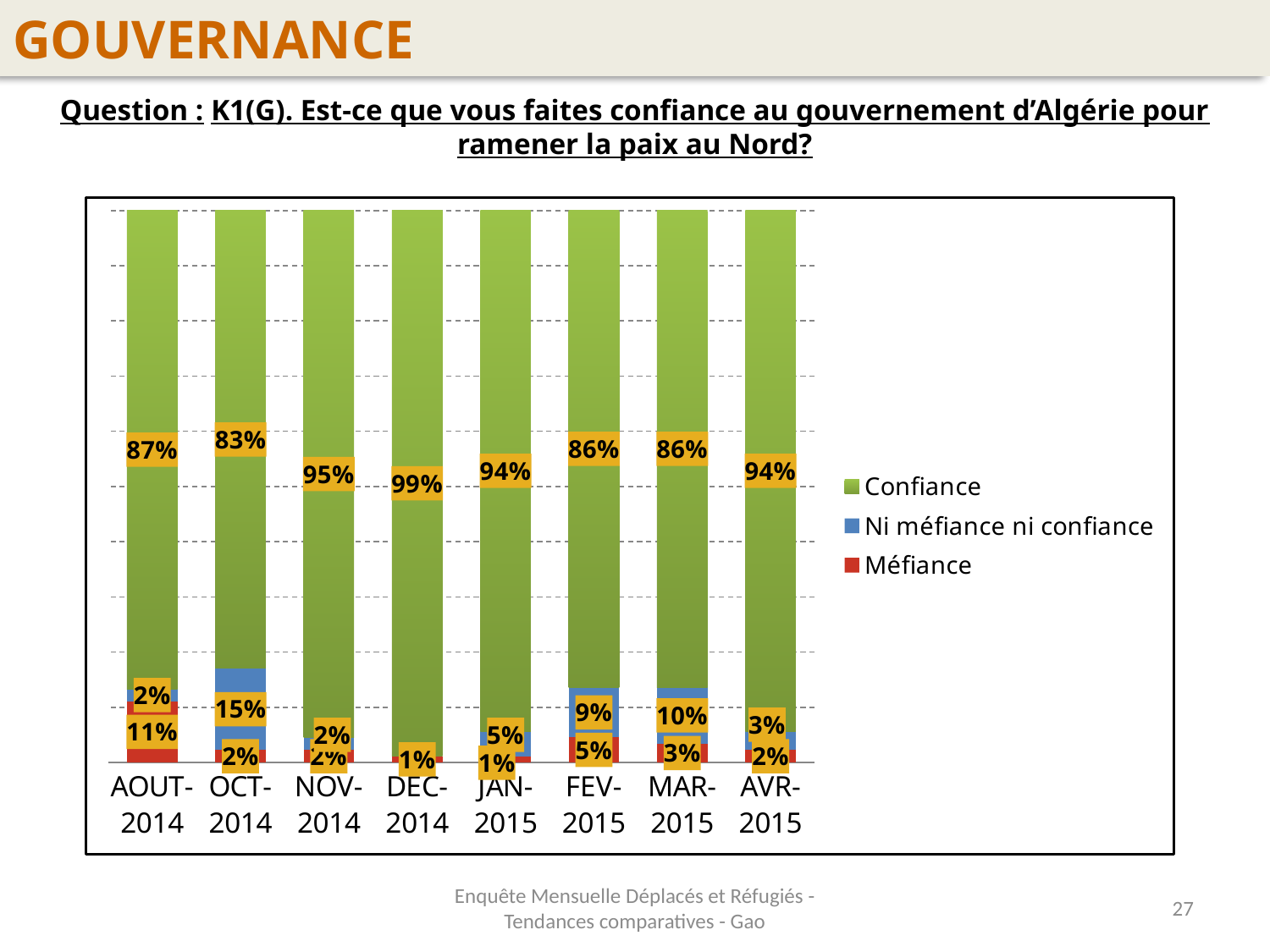
What is the Ni méfiance ni confiance value for MAR-2015? 10% Which is larger, the Ni méfiance ni confiance value for OCT-2014 or for FEV-2015? OCT-2014 How many months are shown on the x axis? 8 Which month has the lowest Confiance value? OCT-2014 Which series is shown in green in the legend? Confiance What type of chart is shown on the slide? stacked bar chart What is the Méfiance value for AOUT-2014? 11% What is the Confiance value for OCT-2014? 83% What is the difference between the Confiance values for NOV-2014 and AOUT-2014? 8% What is the Confiance value for DEC-2014? 99% Which month has the highest Confiance value? DEC-2014 How many series does the legend list? 3